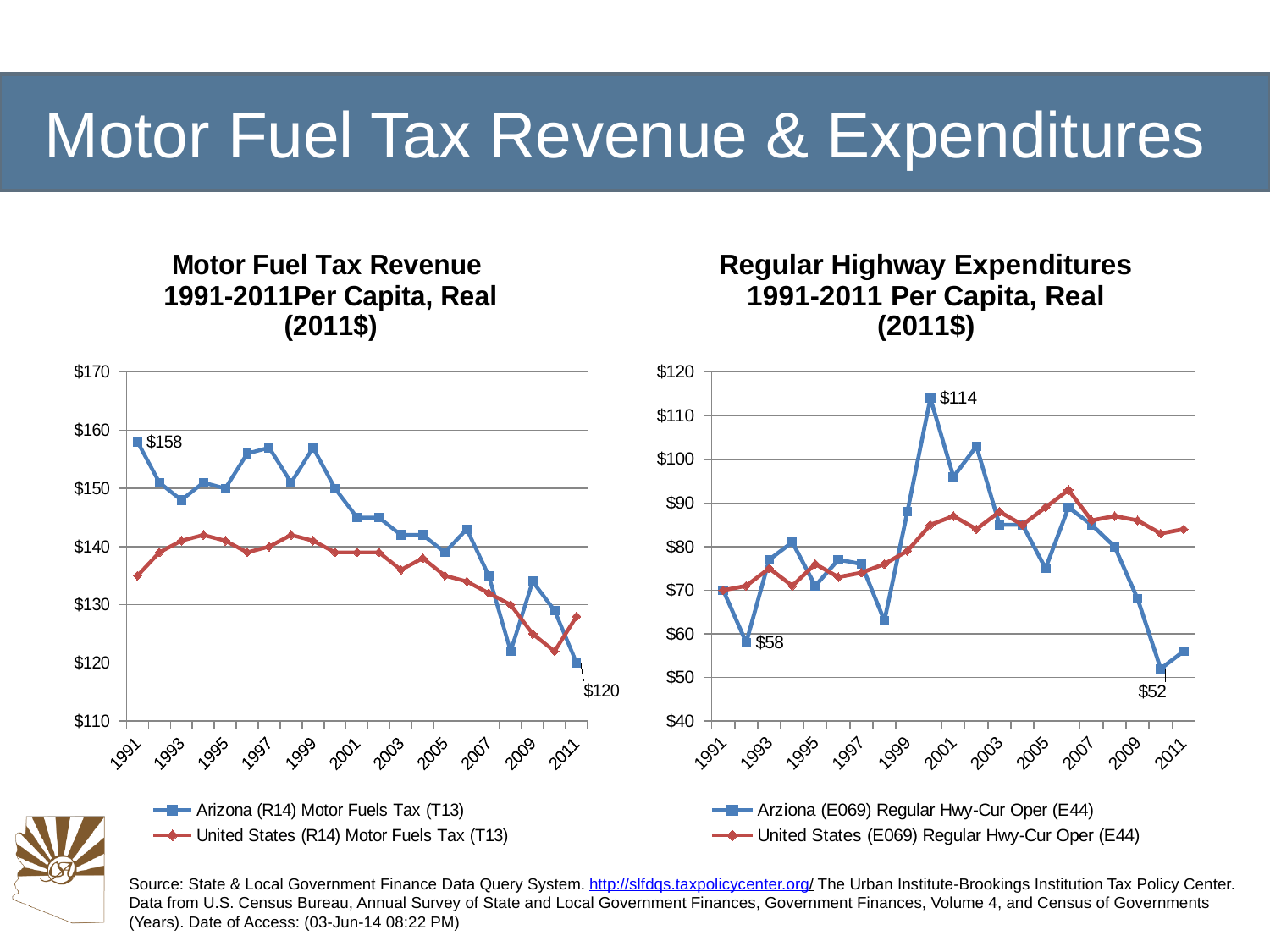
In the Motor Fuel Tax Revenue chart, what is the labeled value for Arizona in 2011? $120 In the Regular Highway Expenditures chart, what is the labeled peak value for Arizona? $114 How many series does the legend of the Regular Highway Expenditures chart list? 2 In the Motor Fuel Tax Revenue chart, what is the labeled value for Arizona in 1991? $158 In the Motor Fuel Tax Revenue chart, is the United States value for 1991 greater or less than $140? less In the Motor Fuel Tax Revenue chart, by how much did Arizona's labeled value fall from 1991 to 2011? $38 In the Regular Highway Expenditures chart, what is the difference between Arizona's labeled peak of $114 and its labeled low of $52? $62 In the Motor Fuel Tax Revenue chart, does the Arizona series overall rise or fall from 1991 to 2011? fall In the Regular Highway Expenditures chart, what is the labeled Arizona value in 1992? $58 What type of chart is the Motor Fuel Tax Revenue chart? line chart In the Regular Highway Expenditures chart, what is the labeled lowest value for Arizona? $52 In the Motor Fuel Tax Revenue chart, which series is higher in 1991, Arizona or United States? Arizona